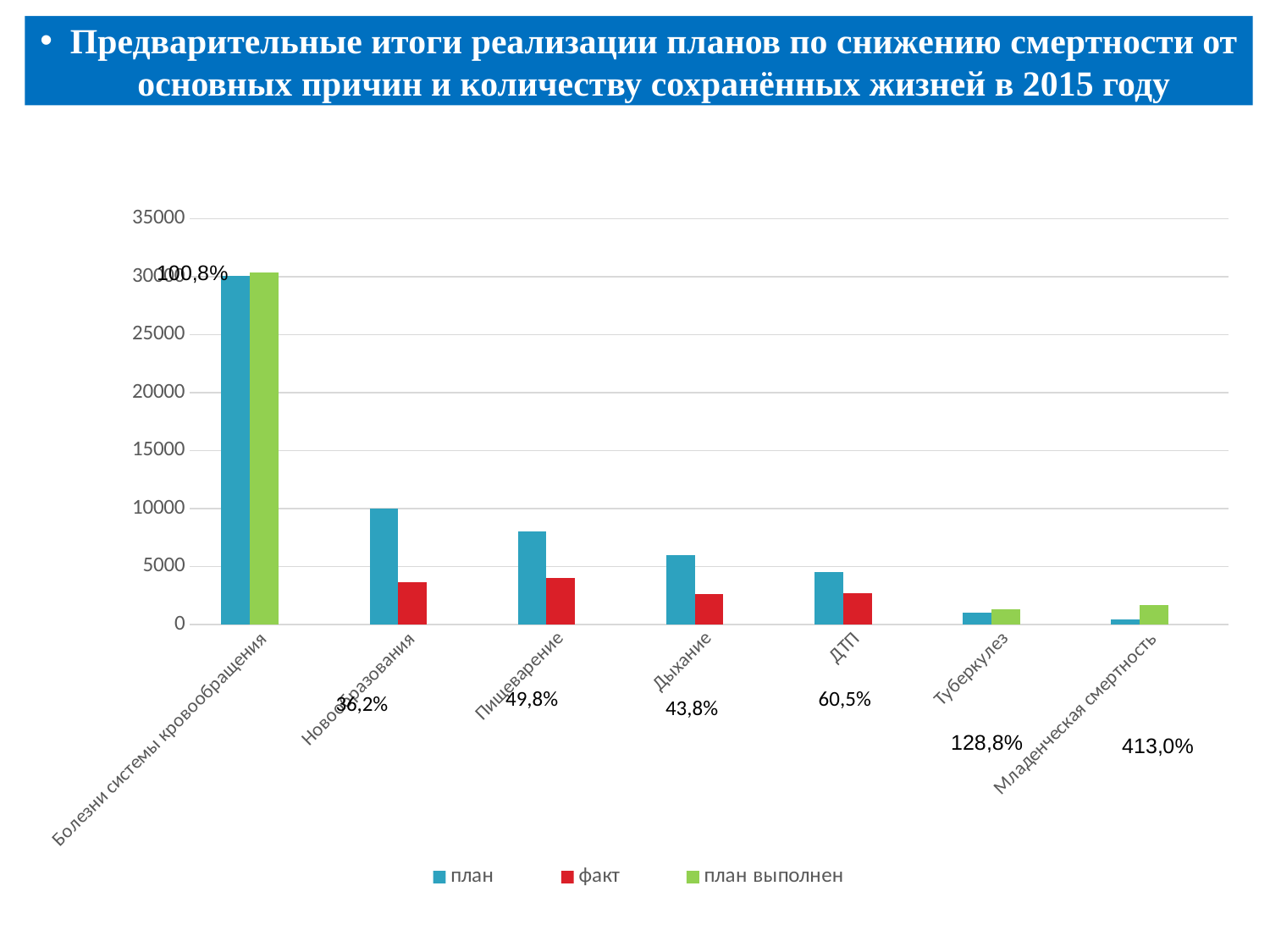
For Новообразования, which is larger: план or факт? план What percentage label is shown for Туберкулез? 128,8% How many categories are shown on the x axis? 7 Do the план values generally rise or fall moving left to right along the x axis? fall What colour are the факт bars? red Which category has the lowest value for the план series? Младенческая смертность How many series does the legend list? 3 Is the план value for ДТП greater or less than 5000? less Which category has the highest value for the план series? Болезни системы кровообращения Is the план value for Болезни системы кровообращения greater or less than 25000? greater Is the план value for Пищеварение greater or less than 5000? greater What kind of chart is shown on the slide? bar chart